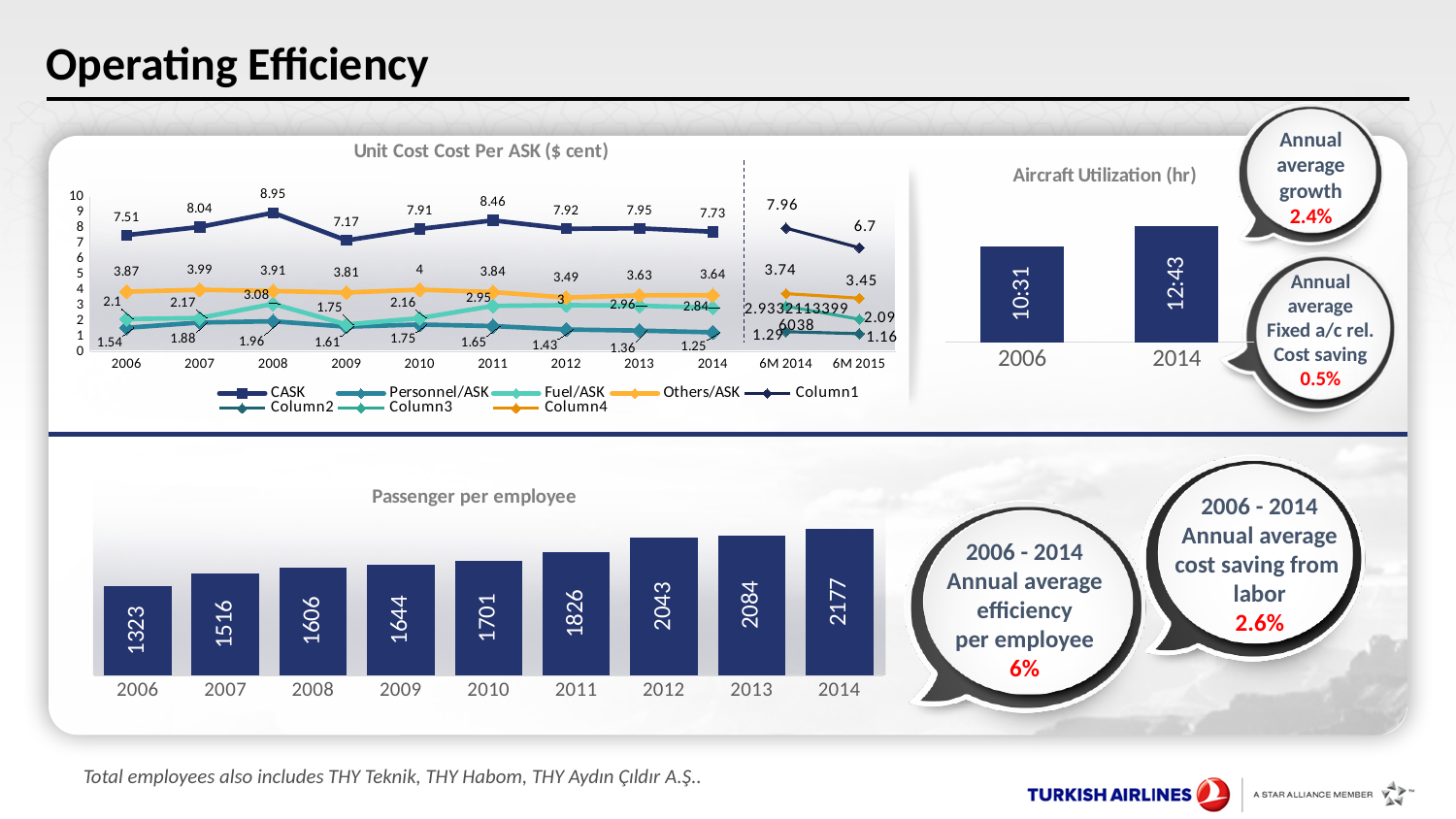
In the 'Passenger per employee' chart, do the values rise or fall from 2006 to 2014? rise In the 'Unit Cost Cost Per ASK ($ cent)' chart, what is the difference between the CASK values for 6M 2014 and 6M 2015? 1.26 In the 'Unit Cost Cost Per ASK ($ cent)' chart, is the Fuel/ASK value for 2008 larger or smaller than the Fuel/ASK value for 2009? larger In the 'Unit Cost Cost Per ASK ($ cent)' chart, which year from 2006 to 2014 has the lowest Personnel/ASK value? 2014 In the 'Aircraft Utilization (hr)' chart, what is the value for 2014? 12:43 In the 'Passenger per employee' chart, what is the value for 2012? 2043 In the 'Unit Cost Cost Per ASK ($ cent)' chart, what is the CASK value for 2008? 8.95 In the 'Unit Cost Cost Per ASK ($ cent)' chart, what is the Others/ASK value for 2010? 4 In the 'Passenger per employee' chart, how many years are shown on the x axis? 9 What type of chart is the 'Aircraft Utilization (hr)' chart? bar chart How many entries does the legend of the 'Unit Cost Cost Per ASK ($ cent)' chart list? 8 In the 'Unit Cost Cost Per ASK ($ cent)' chart, which year from 2006 to 2014 has the highest CASK value? 2008